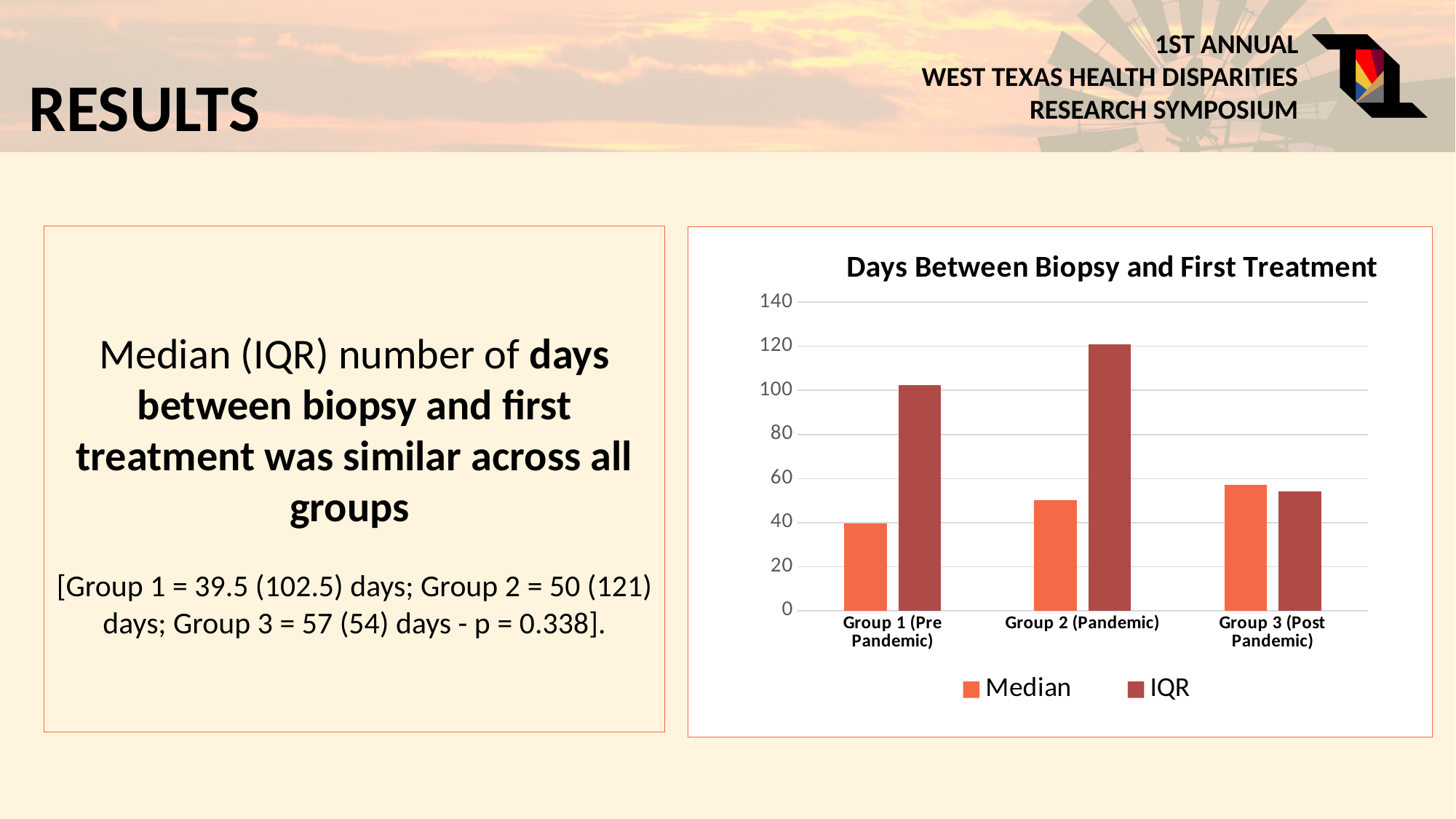
Which group has the highest Median bar? Group 3 (Post Pandemic) Which group has the highest IQR bar? Group 2 (Pandemic) Do the Median values rise or fall from Group 1 to Group 3? rise What is the median number of days between biopsy and first treatment for Group 2, as stated on the slide? 50 What kind of chart is shown on the slide? bar chart For Group 1 (Pre Pandemic), which is larger, the Median bar or the IQR bar? IQR What is the title of the chart? Days Between Biopsy and First Treatment Is the IQR value for Group 1 (Pre Pandemic) greater or less than 80? greater Is the Median value for Group 1 (Pre Pandemic) greater or less than 60? less How many series does the legend of the chart list? 2 Which group has the lowest IQR bar? Group 3 (Post Pandemic) How many groups are shown on the x axis of the chart? 3